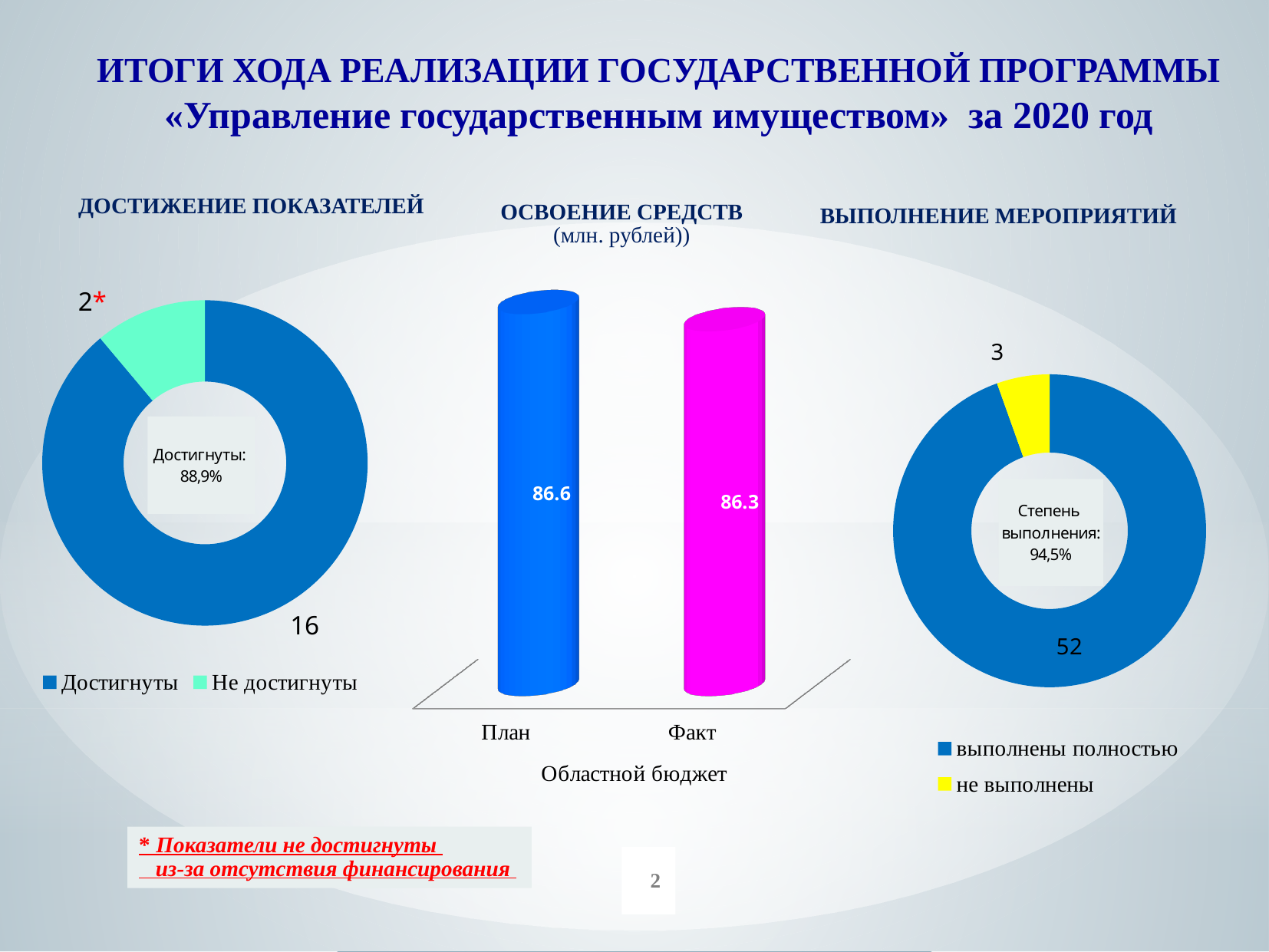
In the «ДОСТИЖЕНИЕ ПОКАЗАТЕЛЕЙ» chart, what percentage is shown in the centre for «Достигнуты»? 88,9% What kind of chart is the «ОСВОЕНИЕ СРЕДСТВ» chart? Bar chart In the «ДОСТИЖЕНИЕ ПОКАЗАТЕЛЕЙ» chart, how many indicators are labelled «Не достигнуты»? 2 In the «ДОСТИЖЕНИЕ ПОКАЗАТЕЛЕЙ» chart, how many indicators are labelled «Достигнуты»? 16 In the «ВЫПОЛНЕНИЕ МЕРОПРИЯТИЙ» chart, how many activities are «выполнены полностью»? 52 In the «ОСВОЕНИЕ СРЕДСТВ» chart, what is the value for «Факт»? 86.3 In the «ОСВОЕНИЕ СРЕДСТВ» chart, what is the value for «План»? 86.6 In the «ВЫПОЛНЕНИЕ МЕРОПРИЯТИЙ» chart, how many activities are «не выполнены»? 3 In the «ДОСТИЖЕНИЕ ПОКАЗАТЕЛЕЙ» chart, what is the total number of indicators across both slices? 18 In the «ДОСТИЖЕНИЕ ПОКАЗАТЕЛЕЙ» chart, how many entries does the legend list? 2 In the «ОСВОЕНИЕ СРЕДСТВ» chart, what is the difference between «План» and «Факт»? 0.3 In the «ВЫПОЛНЕНИЕ МЕРОПРИЯТИЙ» chart, which category is larger: «выполнены полностью» or «не выполнены»? выполнены полностью